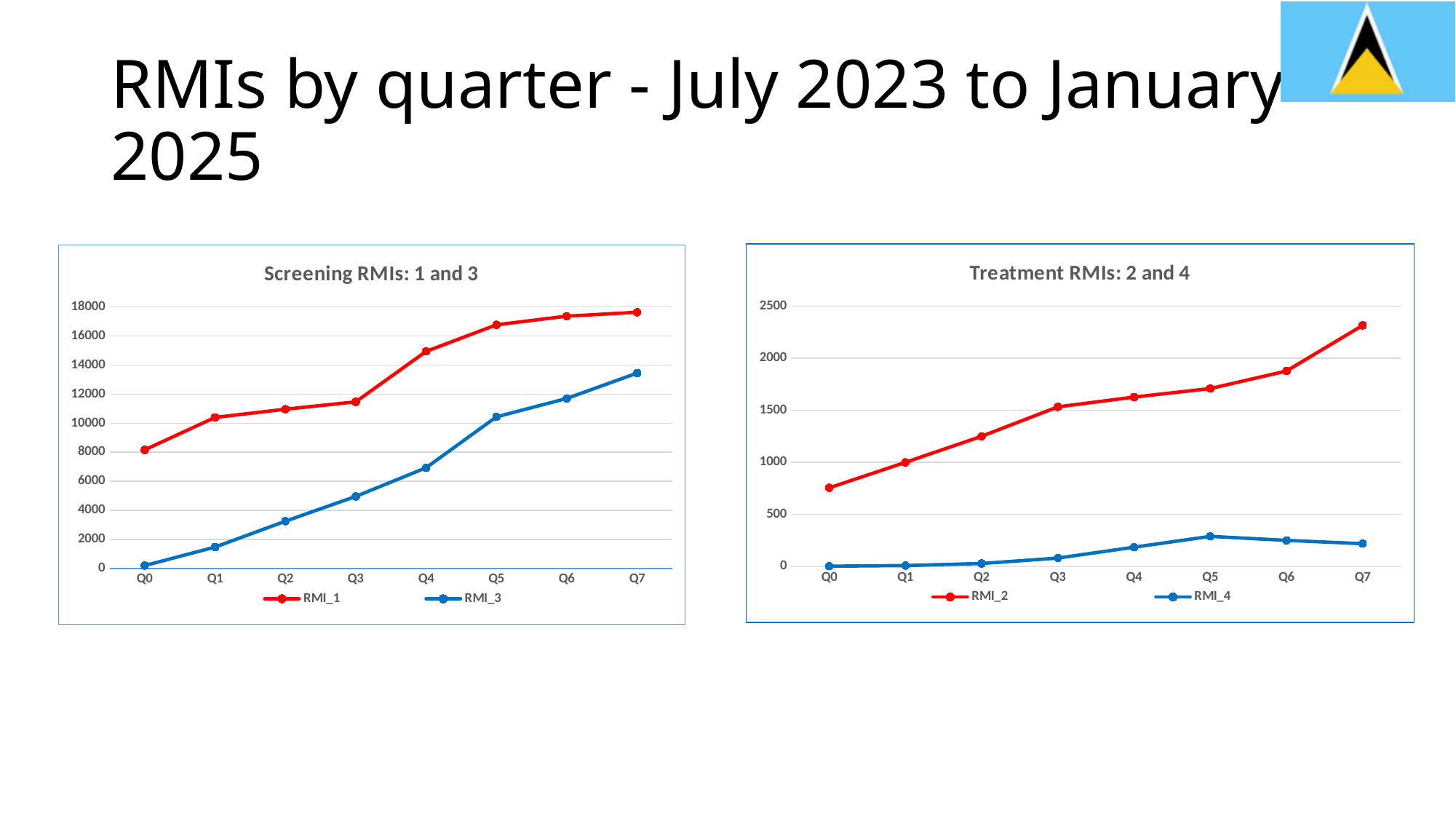
In the 'Screening RMIs: 1 and 3' chart, at which quarter is RMI_3 lowest? Q0 In the 'Screening RMIs: 1 and 3' chart, is the value of RMI_1 at Q0 greater or less than 10000? less In the 'Treatment RMIs: 2 and 4' chart, at which quarter is RMI_4 highest? Q5 In the 'Treatment RMIs: 2 and 4' chart, does RMI_2 rise or fall from Q0 to Q7? rise In the 'Treatment RMIs: 2 and 4' chart, what colour is the RMI_4 line? blue In the 'Screening RMIs: 1 and 3' chart, which series is higher at Q4, RMI_1 or RMI_3? RMI_1 In the 'Screening RMIs: 1 and 3' chart, what type of chart is shown? line chart In the 'Screening RMIs: 1 and 3' chart, how many quarters are plotted on the x axis? 8 In the 'Screening RMIs: 1 and 3' chart, at which quarter is RMI_1 highest? Q7 In the 'Treatment RMIs: 2 and 4' chart, is the value of RMI_2 at Q7 greater or less than 2000? greater In the 'Screening RMIs: 1 and 3' chart, how many series does the legend list? 2 In the 'Screening RMIs: 1 and 3' chart, is the value of RMI_3 at Q7 greater or less than 12000? greater